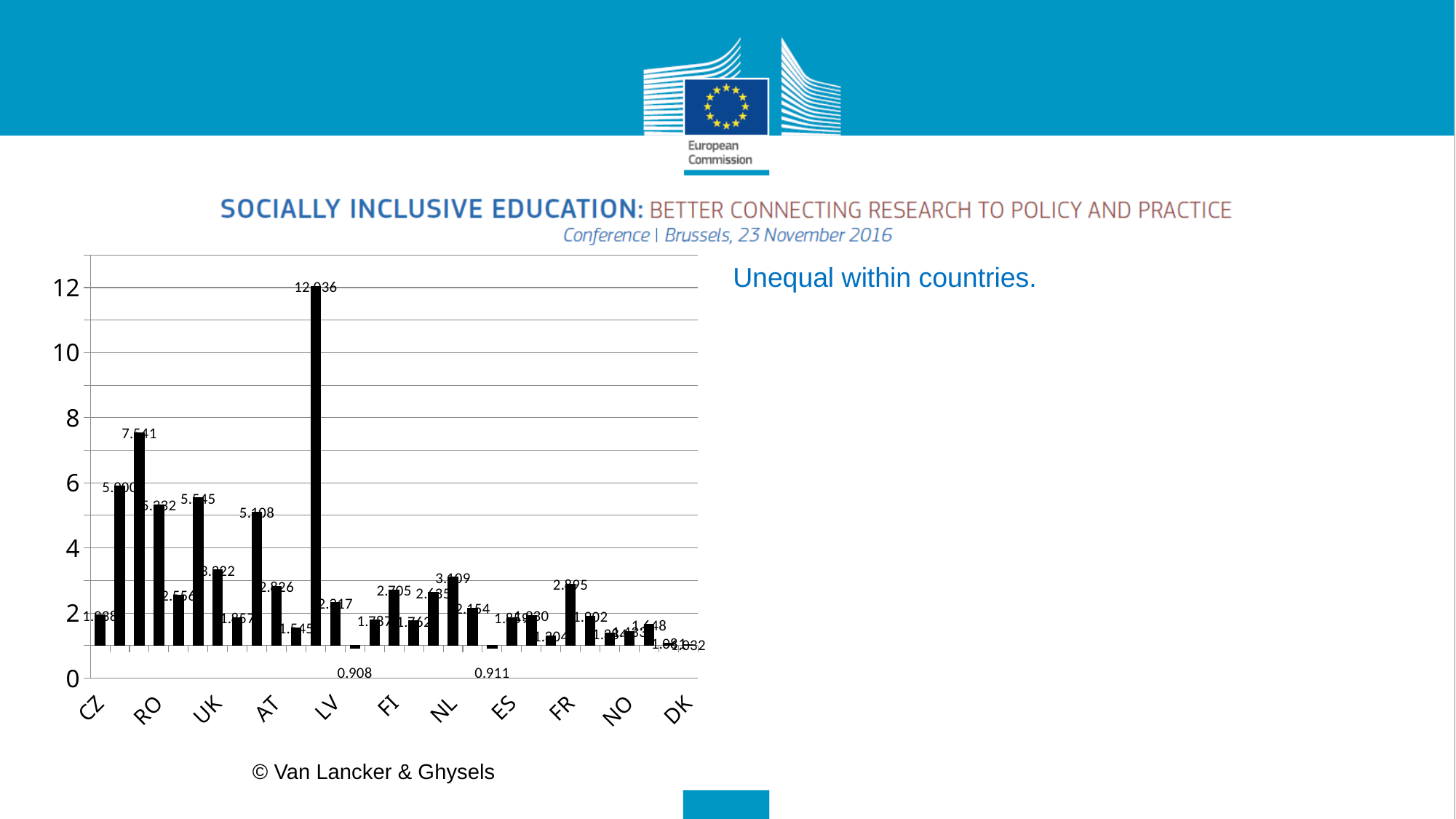
Is the value for RO greater or less than 4? greater What is the highest value labelled on the chart? 12.036 Is the value for DK greater or less than 2? less What is the value for UK? 3.322 What is the value for NL? 3.109 What is the lowest value labelled on the chart? 0.908 What text appears to the right of the chart as its heading? Unequal within countries. What type of chart is shown on the slide? bar chart How many country labels are shown on the x axis? 11 What is the value for FR? 2.895 What is the value for RO? 5.332 Which is larger, the value for RO or the value for UK? RO